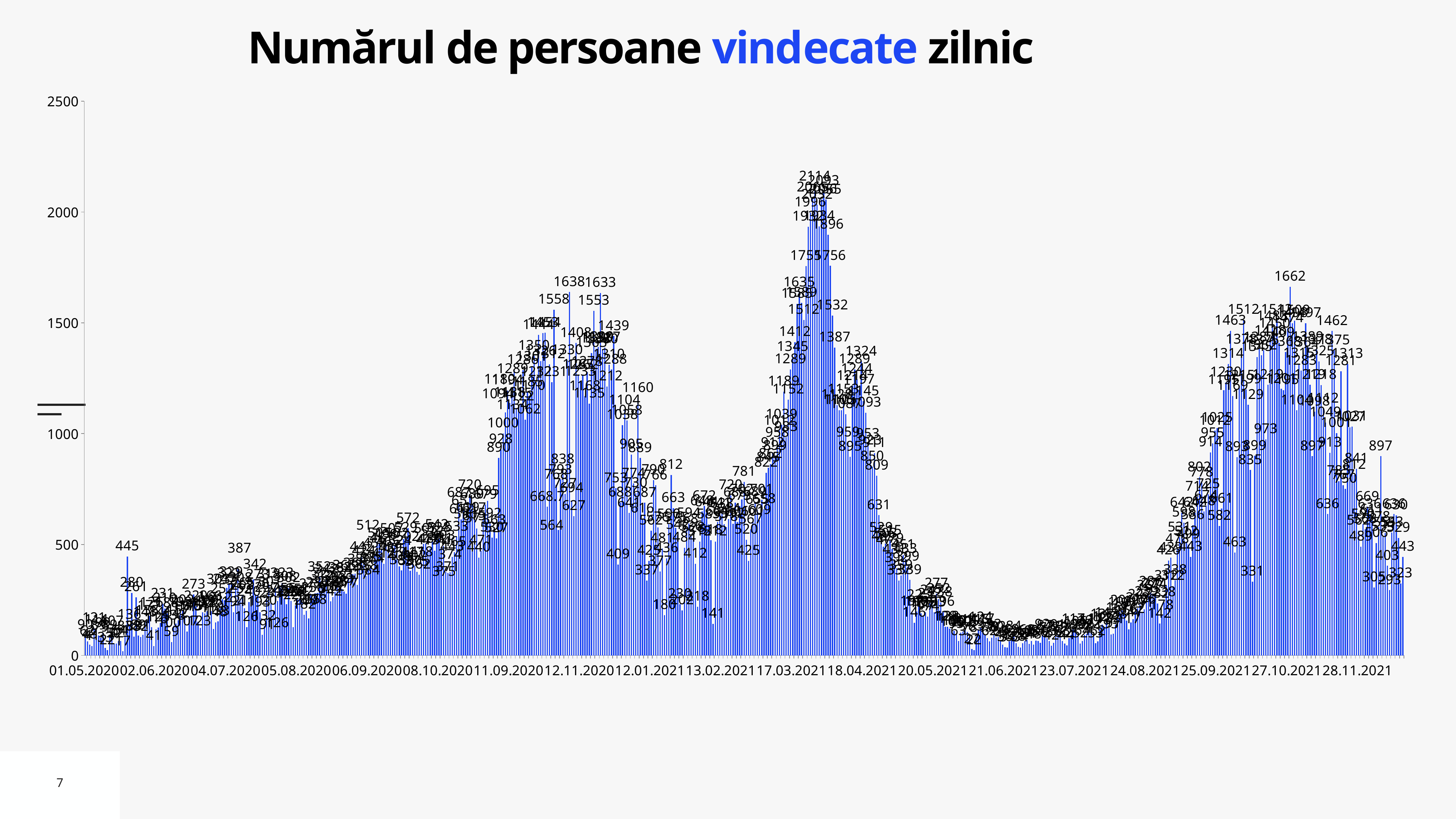
Which wave reaches a higher peak: the one around 12.11.2020 or the one around 17.03.2021–18.04.2021? the one around 17.03.2021–18.04.2021 What is the title of the chart? Numărul de persoane vindecate zilnic Do the values rise or fall between 18.04.2021 and 21.06.2021? fall What is the highest daily value labelled on the chart? 2114 Is the peak value in the wave between 17.03.2021 and 18.04.2021 greater or less than 2000? greater Are the values around 21.06.2021 greater or less than 500? less What is the difference between the overall peak value (2114) and the peak of the autumn 2021 wave (1662)? 452 What is the highest labelled value in the wave around 27.10.2021? 1662 What is the highest tick value shown on the y axis? 2500 What kind of chart is shown on the slide? bar chart What is the highest labelled value in the wave around 12.11.2020? 1638 Is the peak value in the wave around 12.11.2020 greater or less than 2000? less